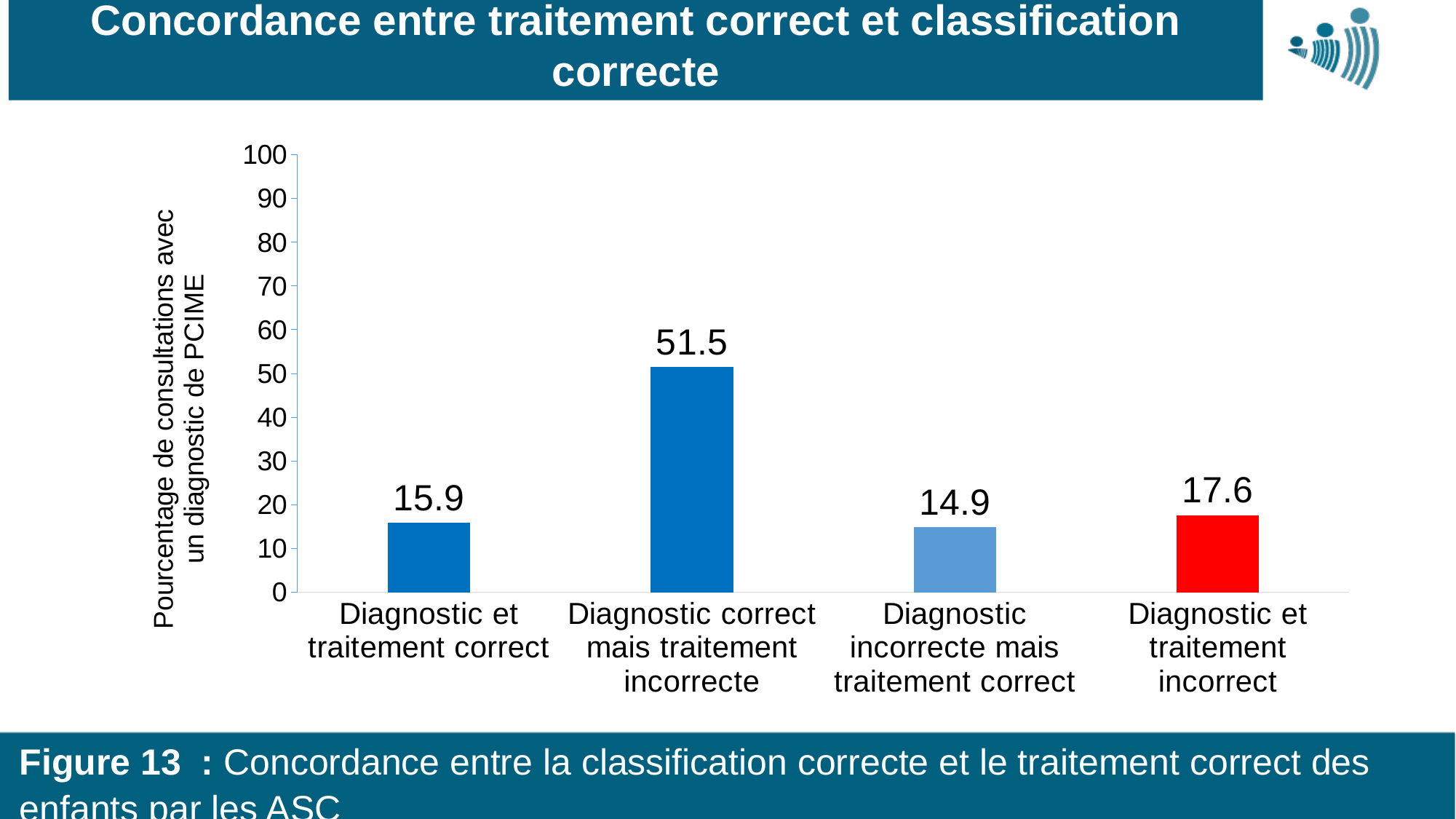
What is the value for "Diagnostic et traitement correct"? 15.9 What is the difference between the values for "Diagnostic et traitement incorrect" and "Diagnostic incorrecte mais traitement correct"? 2.7 What is the value for "Diagnostic incorrecte mais traitement correct"? 14.9 What is the difference between the values for "Diagnostic correct mais traitement incorrecte" and "Diagnostic et traitement correct"? 35.6 What is the value for "Diagnostic et traitement incorrect"? 17.6 How many categories are shown on the chart? 4 Which is larger: the value for "Diagnostic et traitement incorrect" or for "Diagnostic et traitement correct"? Diagnostic et traitement incorrect What is the value for "Diagnostic correct mais traitement incorrecte"? 51.5 Is the value for "Diagnostic correct mais traitement incorrecte" greater or less than 50? greater Which category has the highest value? Diagnostic correct mais traitement incorrecte Which category has the lowest value? Diagnostic incorrecte mais traitement correct What kind of chart is shown on the slide? bar chart